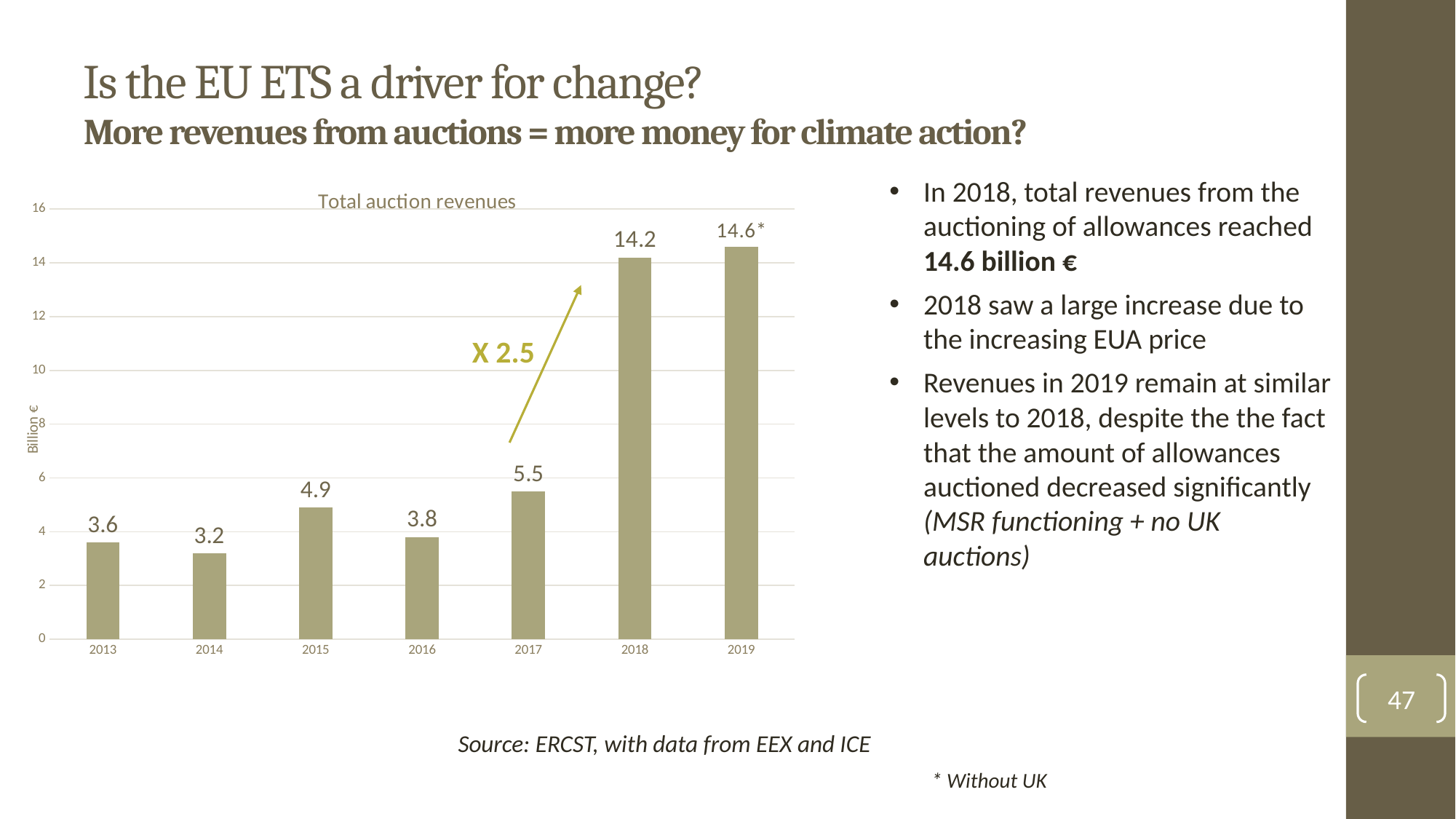
Which year has the highest total auction revenue? 2019 Which year has a larger total auction revenue, 2013 or 2016? 2016 What is the total auction revenue shown for 2015? 4.9 What is the total auction revenue shown for 2019? 14.6 What is the difference between the total auction revenues for 2018 and 2017? 8.7 Which year has the lowest total auction revenue? 2014 What is the title of the chart? Total auction revenues What unit is shown on the y axis of the chart? Billion € What kind of chart is used to show total auction revenues? bar chart Is the value for 2017 greater or less than 6? less What is the total auction revenue shown for 2018? 14.2 How many years are shown on the x axis of the chart? 7